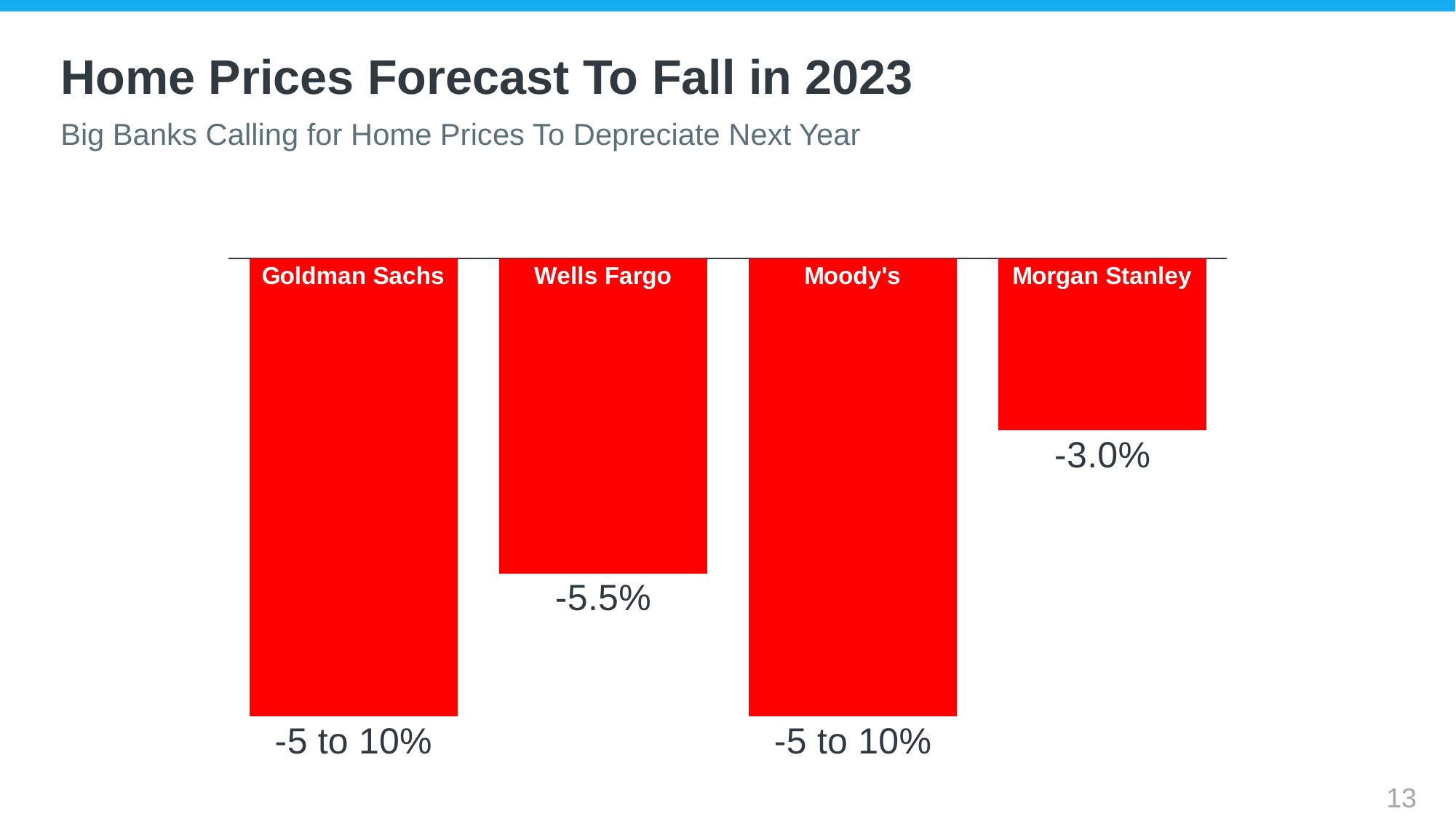
What is the title of the slide? Home Prices Forecast To Fall in 2023 What is the forecast value shown for Moody's? -5 to 10% Which two firms have the same forecast range shown? Goldman Sachs and Moody's Which firm forecasts the smallest decline in home prices? Morgan Stanley By how many percentage points does the Wells Fargo forecast decline exceed the Morgan Stanley forecast decline? 2.5 percentage points What is the forecast value shown for Goldman Sachs? -5 to 10% What is the forecast value shown for Morgan Stanley? -3.0% What kind of chart is shown on the slide? Bar chart What colour are the bars in the chart? Red How many banks or firms are shown in the chart? 4 Which forecasts a larger decline in home prices, Wells Fargo or Morgan Stanley? Wells Fargo What is the forecast value shown for Wells Fargo? -5.5%